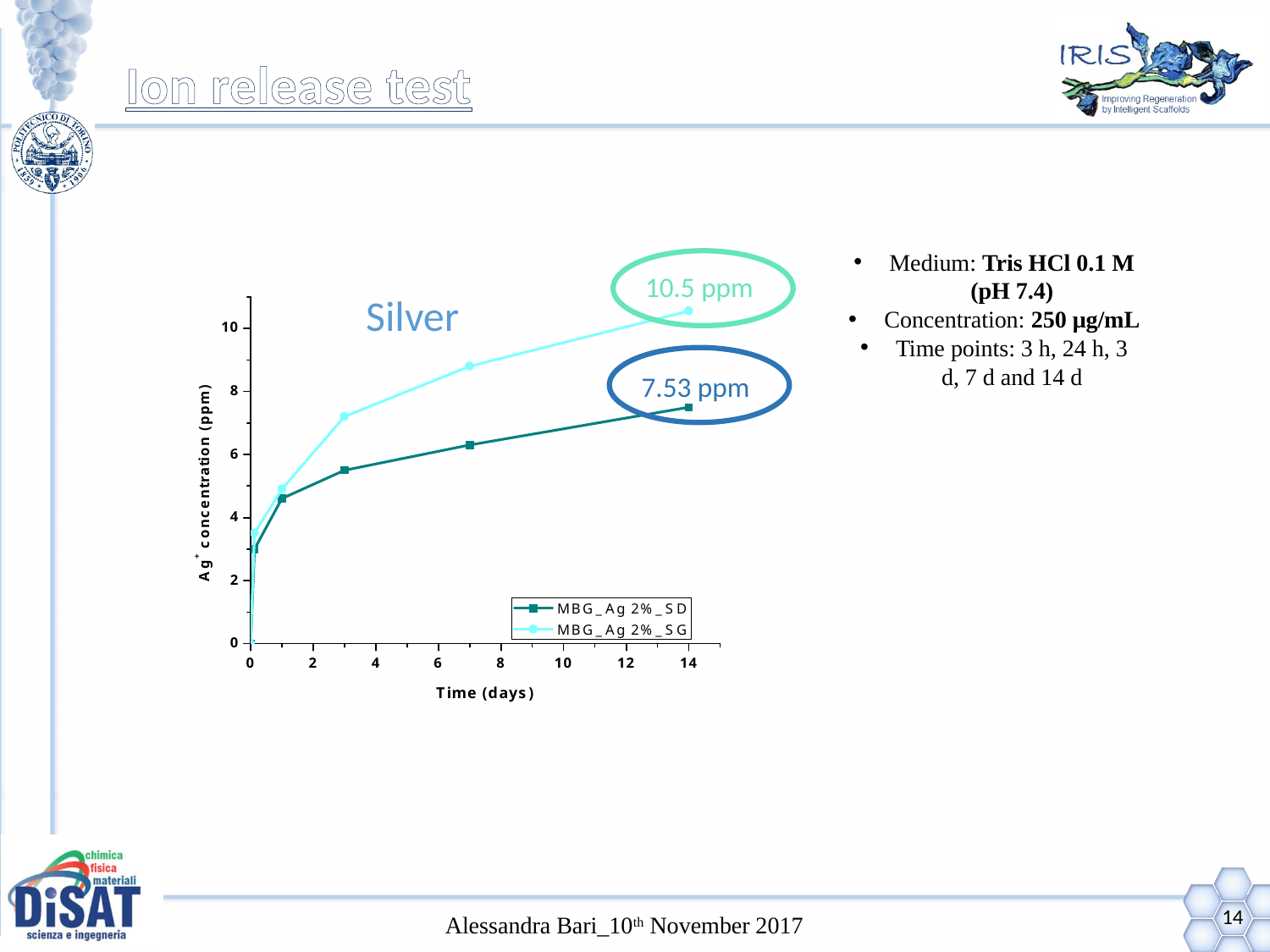
What is the Ag+ concentration for MBG_Ag 2%_SD at 14 days, as annotated on the chart? 7.53 ppm Do the Ag+ concentration values rise or fall as time increases along the x axis? Rise What is the difference between the annotated 14-day values of MBG_Ag 2%_SG and MBG_Ag 2%_SD? 2.97 ppm Is the value for MBG_Ag 2%_SG at 7 days greater or less than 8? greater Which series reaches the higher Ag+ concentration at 14 days, MBG_Ag 2%_SD or MBG_Ag 2%_SG? MBG_Ag 2%_SG How many series does the legend list? 2 What is the label of the x axis of the chart? Time (days) Is the value for MBG_Ag 2%_SD at 3 days greater or less than 6? less What kind of chart is shown on the slide? Line chart What is the Ag+ concentration for MBG_Ag 2%_SG at 14 days, as annotated on the chart? 10.5 ppm How many data points are plotted for each series? 5 Is the value for MBG_Ag 2%_SD at 7 days greater or less than 6? greater